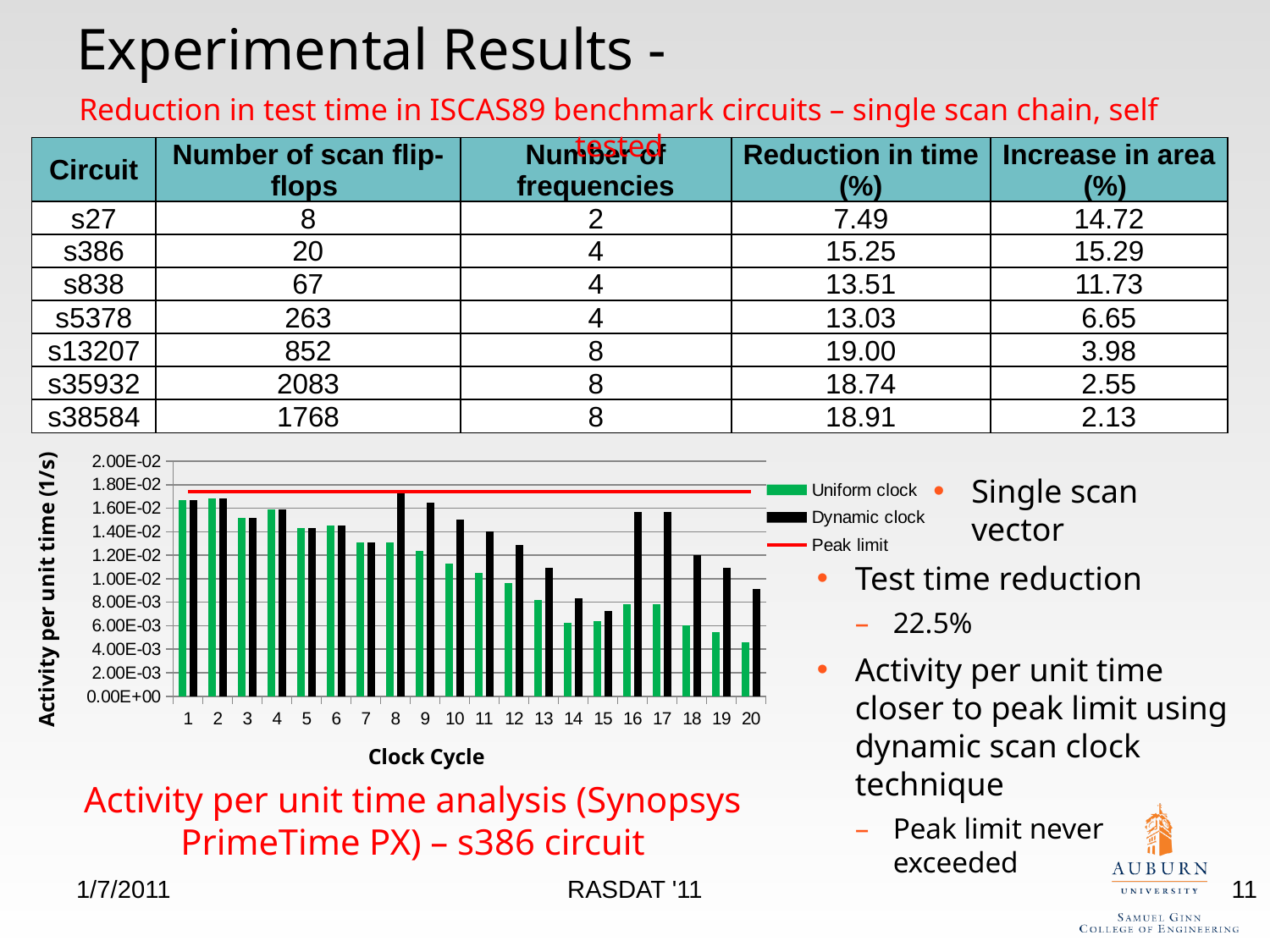
At clock cycle 8, which is larger: the Uniform clock value or the Dynamic clock value? Dynamic clock What kind of chart is shown on the slide? Combination bar and line chart At which clock cycle is the Dynamic clock value highest? 8 How many clock cycles are plotted along the x axis of the chart? 20 Is the Uniform clock value at clock cycle 1 greater or less than 1.40E-02? greater Is the Uniform clock value at clock cycle 20 greater or less than 6.00E-03? less What is the title of the chart's y axis? Activity per unit time (1/s) Is the Dynamic clock value at clock cycle 20 greater or less than 1.00E-02? less How many series does the chart legend list? 3 What colour is the Peak limit line in the chart? Red Do the Uniform clock values generally rise or fall from clock cycle 1 to clock cycle 20? fall